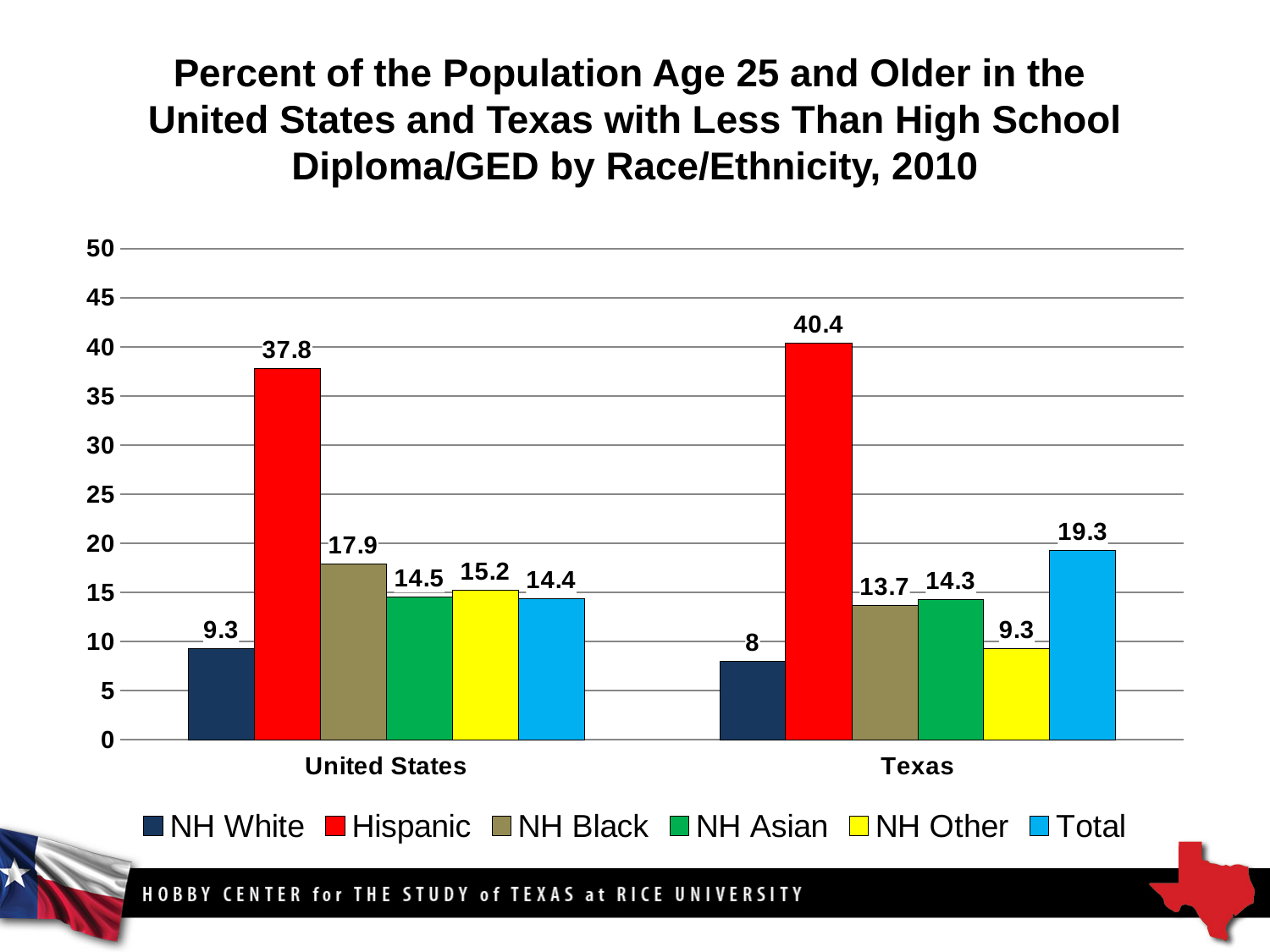
What colour represents Hispanic in the chart? Red Which group has the highest value in the United States? Hispanic How many series does the legend list? 6 Which group has the lowest value in Texas? NH White What is the value for NH Black in the United States? 17.9 What is the Total value for the United States? 14.4 Which is larger, the Total value for Texas or the Total value for the United States? Texas What is the value for Hispanic in Texas? 40.4 Is the value for NH Black in Texas greater or less than 15? less What is the value for NH White in Texas? 8 What kind of chart is shown on the slide? Bar chart What is the difference between the Hispanic values for Texas and the United States? 2.6